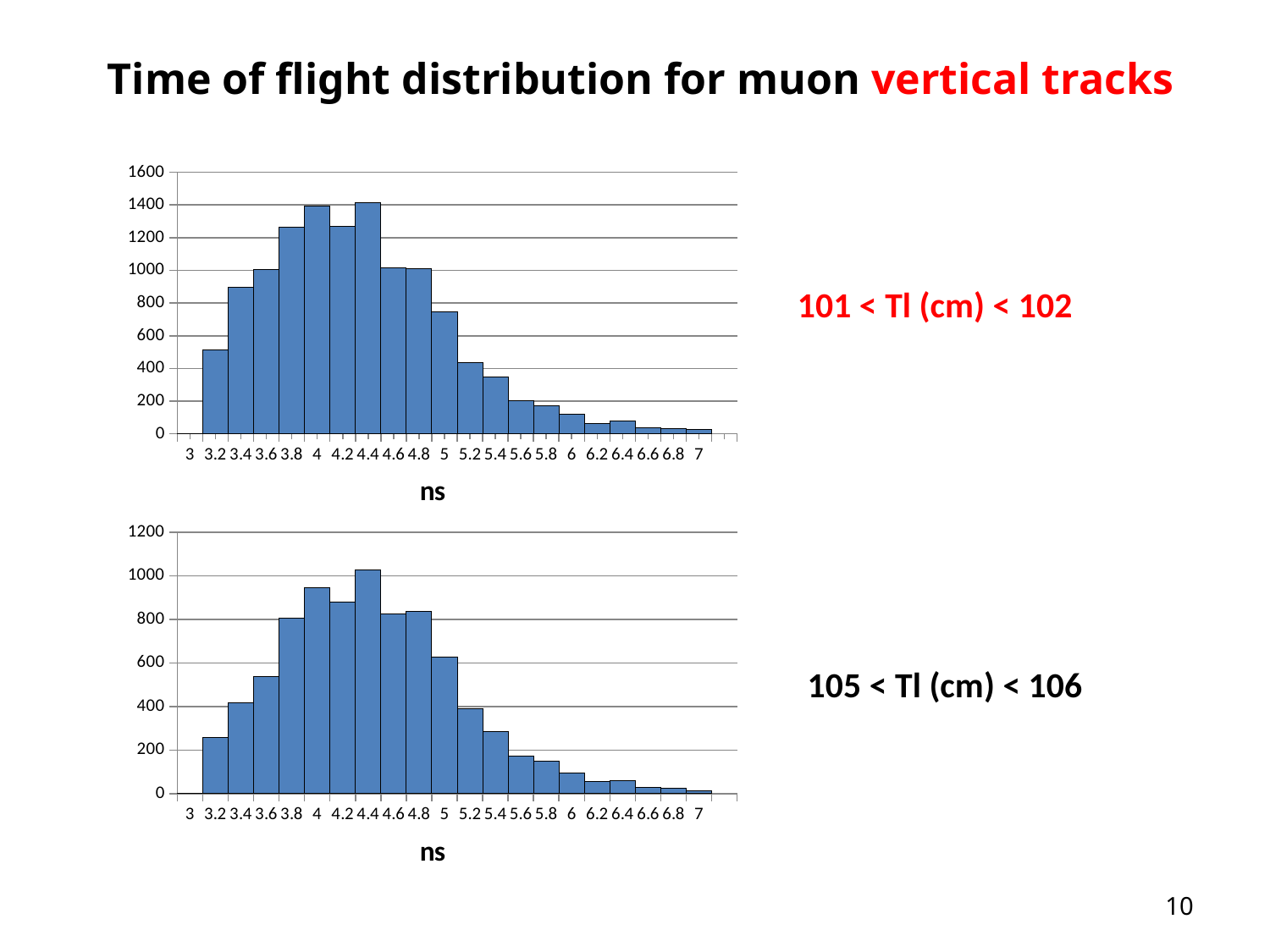
In the top chart, is the value for 3.2 greater or less than 400? greater In the bottom chart, is the value for 4.4 greater or less than 1000? greater In the bottom chart, is the value for 3.2 greater or less than 200? greater What kind of chart is the top chart on the slide? bar chart In the top chart, which is larger, the value for 3.4 or the value for 5? 3.4 In the bottom chart, which is larger, the value for 4.6 or the value for 5.2? 4.6 In the bottom chart, which x-axis bin has the highest value? 4.4 What is the x-axis label of the top chart? ns In the bottom chart, do the values rise or fall along the x axis from 4.4 to 7? fall